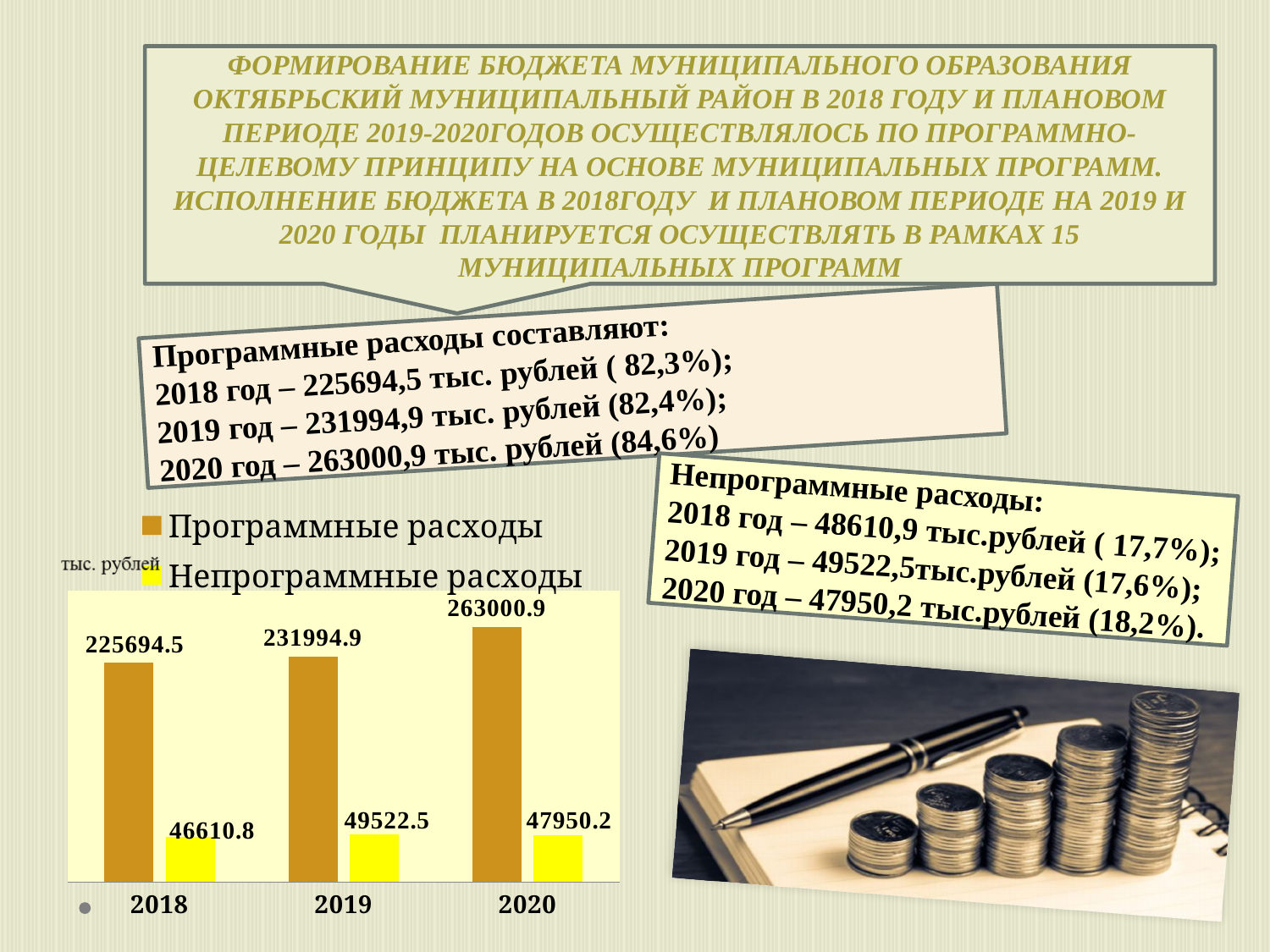
In which year is Непрограммные расходы lowest in the chart? 2018 Which is larger in the chart: Непрограммные расходы in 2019 or in 2020? 2019 How many series does the chart legend list? 2 What is the value of Непрограммные расходы for 2018 in the chart? 46610.8 What is the value of Программные расходы for 2020 in the chart? 263000.9 What is the difference between Программные расходы in 2020 and in 2019 in the chart? 31006.0 What kind of chart is shown on the slide? bar chart What is the value of Программные расходы for 2018 in the chart? 225694.5 What is the value of Непрограммные расходы for 2019 in the chart? 49522.5 How many years are shown on the x axis of the chart? 3 Do the values of Программные расходы rise or fall from 2018 to 2020 in the chart? rise In which year is Программные расходы highest in the chart? 2020